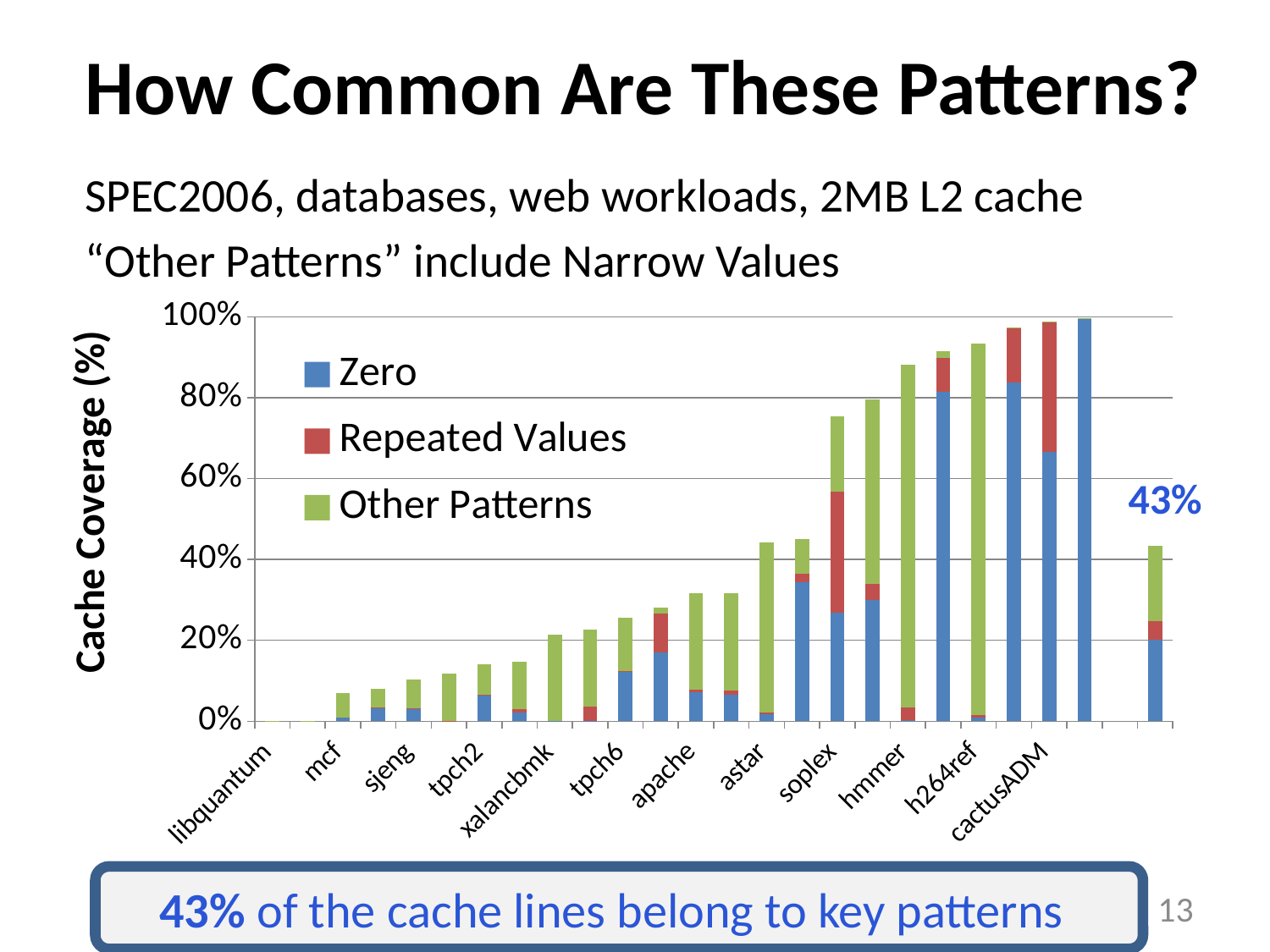
Is the total value for hmmer greater or less than 60%? greater What value is printed above the rightmost bar of the chart? 43% Is the total value for libquantum greater or less than 20%? less What kind of chart is shown on the slide? stacked bar chart Is the total value for cactusADM greater or less than 80%? greater Do the bar totals rise or fall from left to right across the workloads? rise How many series does the chart legend list? 3 Which has a larger total cache coverage, cactusADM or libquantum? cactusADM What is the label of the y axis? Cache Coverage (%) Which has a larger total cache coverage, hmmer or mcf? hmmer